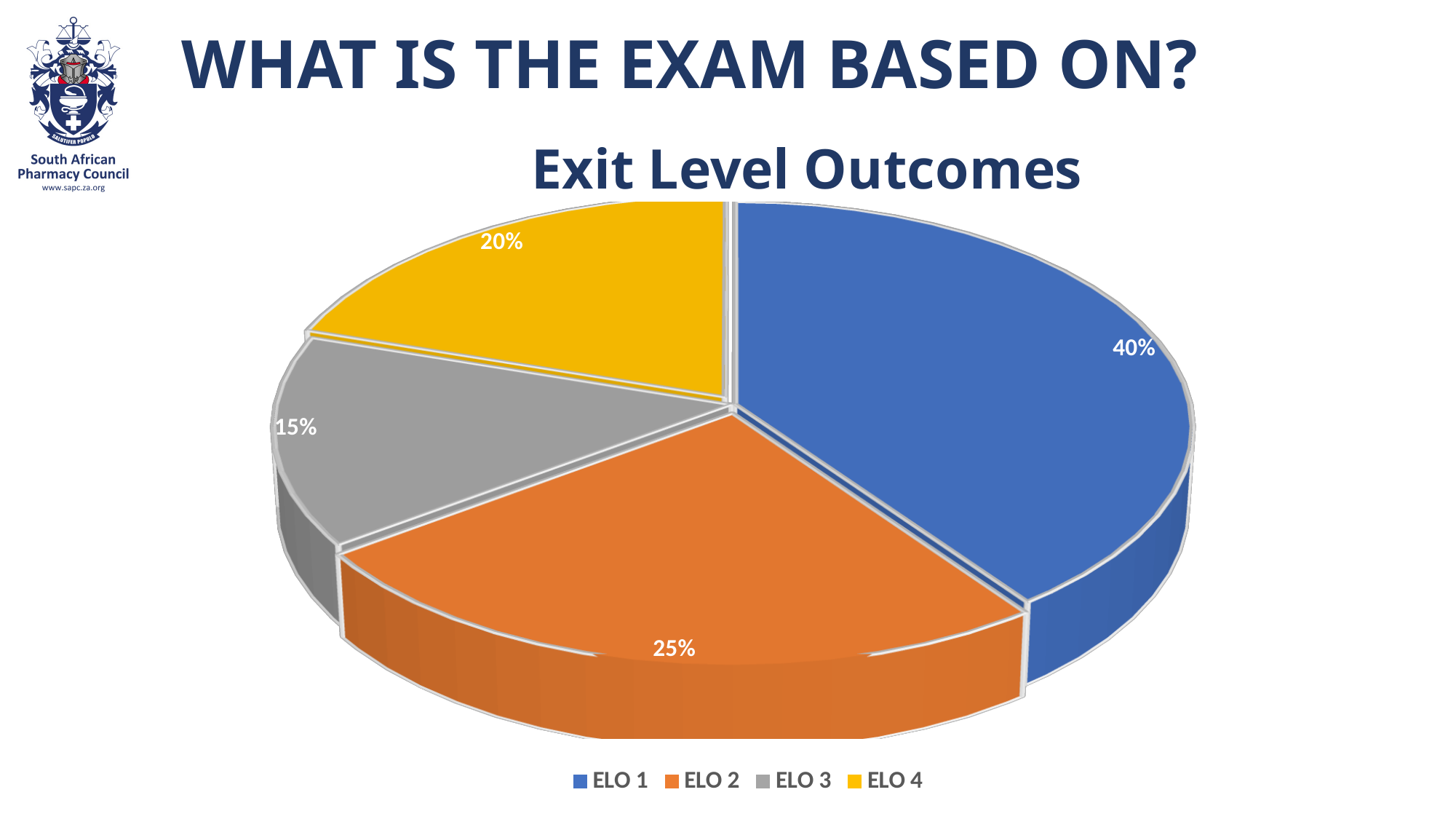
What percentage does ELO 4 account for? 20% What percentage does ELO 1 account for? 40% What is the difference between the shares of ELO 1 and ELO 2? 15% Which category has the largest share of the pie? ELO 1 Which category has the smallest share of the pie? ELO 3 What is the title of the chart? Exit Level Outcomes What percentage does ELO 3 account for? 15% How many categories does the legend list? 4 Which has a larger share, ELO 3 or ELO 4? ELO 4 What type of chart is shown on the slide? Pie chart What percentage does ELO 2 account for? 25% What colour represents ELO 2 in the chart? Orange